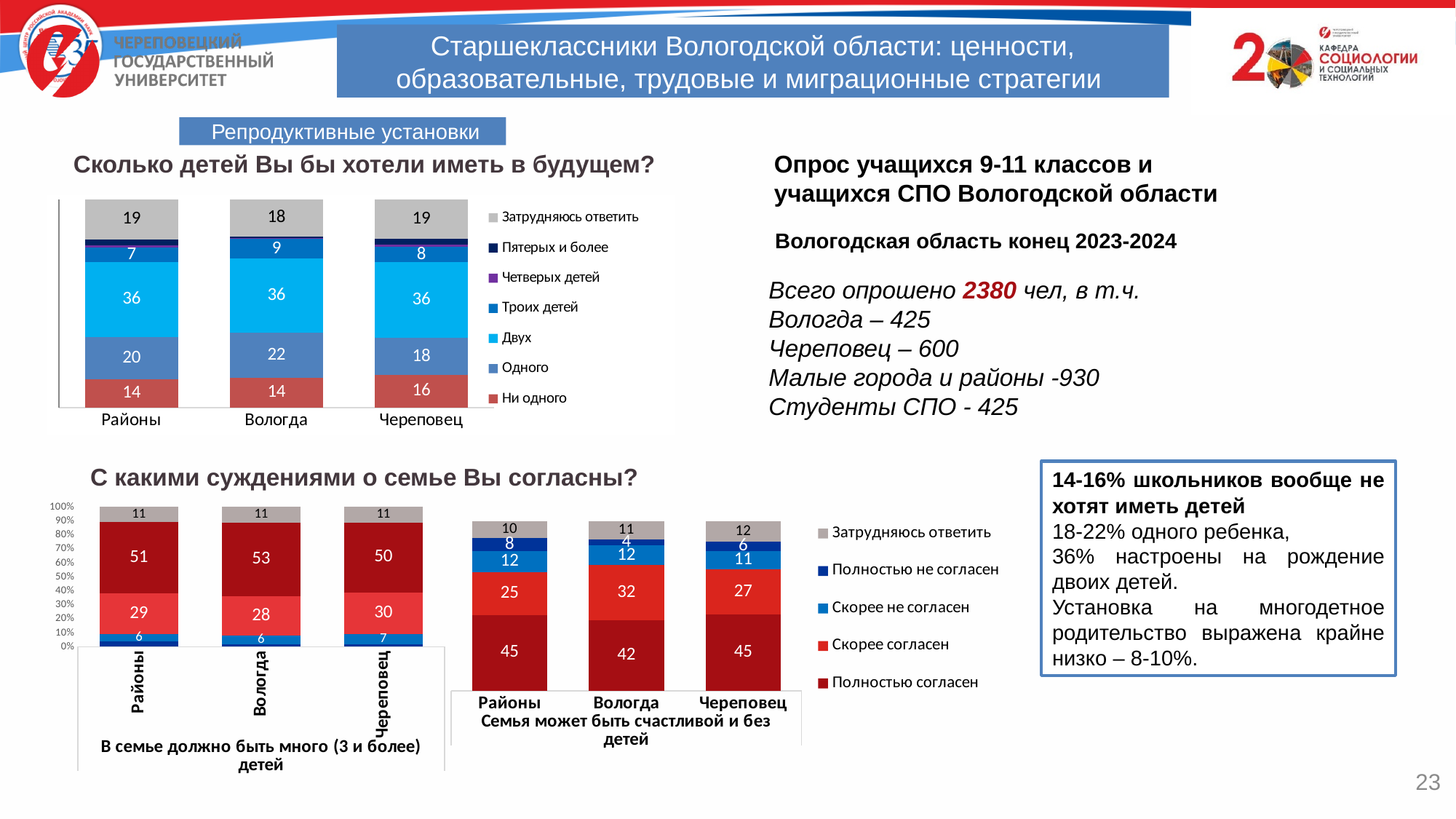
In the chart 'Семья может быть счастливой и без детей', what is the value for 'Полностью согласен' in Вологда? 42 How many series does the legend of the chart 'Сколько детей Вы бы хотели иметь в будущем?' list? 7 In the chart 'Сколько детей Вы бы хотели иметь в будущем?', which category has the highest value for 'Одного'? Вологда In the chart 'Семья может быть счастливой и без детей', which category has the lowest value for 'Полностью не согласен'? Вологда In the chart 'Семья может быть счастливой и без детей', which is larger for 'Скорее согласен': Вологда or Районы? Вологда In the chart 'Сколько детей Вы бы хотели иметь в будущем?', what is the difference between the 'Одного' values for Вологда and Череповец? 4 In the chart 'Сколько детей Вы бы хотели иметь в будущем?', what is the value for 'Одного' in Вологда? 22 In the chart 'Сколько детей Вы бы хотели иметь в будущем?', what is the value for 'Ни одного' in Череповец? 16 In the legend of the bottom charts ('С какими суждениями о семье Вы согласны?'), which entry is shown in dark red? Полностью согласен How many categories are shown on the x axis of the chart 'Сколько детей Вы бы хотели иметь в будущем?'? 3 What kind of chart is 'Сколько детей Вы бы хотели иметь в будущем?'? Stacked bar chart